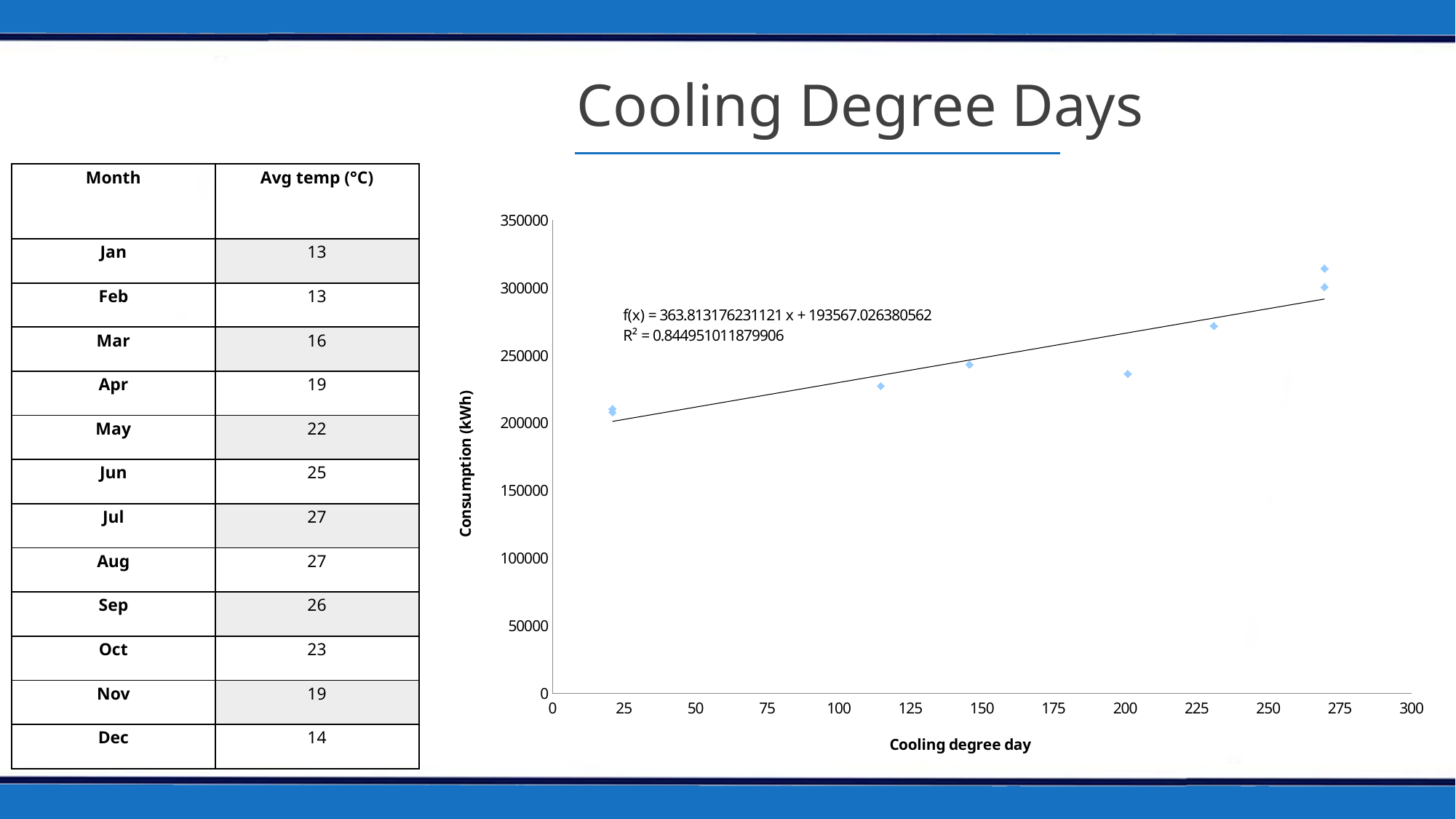
What kind of chart is shown on the slide? scatter chart What is the title of the x axis of the chart? Cooling degree day What is the highest tick value shown on the y axis of the chart? 350000 What is the title of the y axis of the chart? Consumption (kWh) Is the consumption value for the highest point near 270 cooling degree days greater or less than 300000? greater Does the point with the highest consumption lie at the left end or the right end of the x axis? right end Is the consumption value for the point at about 230 cooling degree days greater or less than 250000? greater Which has the higher consumption: the point at about 230 cooling degree days or the point at about 200 cooling degree days? the point at about 230 cooling degree days Is the consumption value for the point at about 115 cooling degree days greater or less than 200000? greater Do the consumption values generally rise or fall as the cooling degree day increases along the x axis? rise